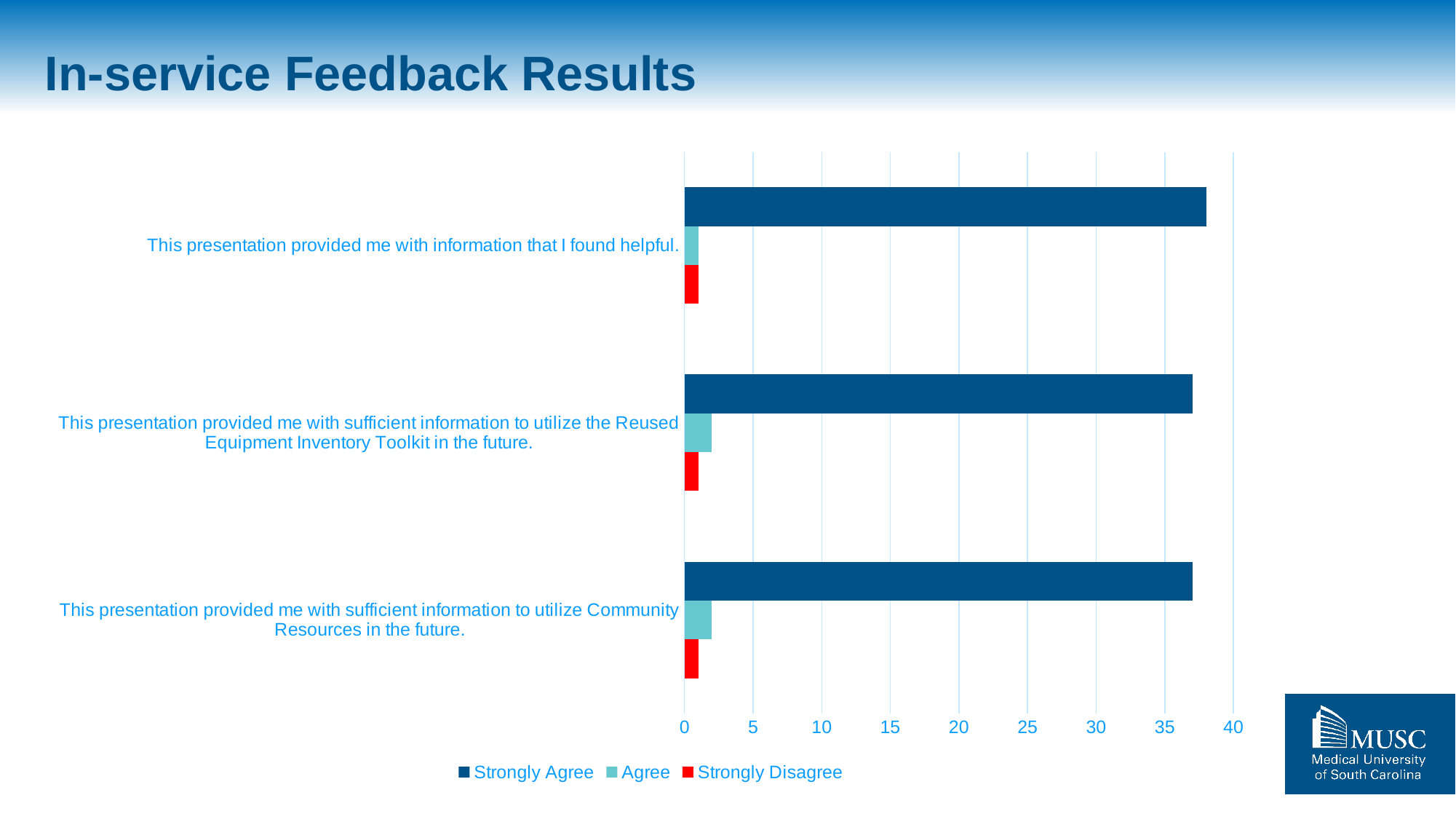
Is the Agree value for "This presentation provided me with sufficient information to utilize the Reused Equipment Inventory Toolkit in the future." greater or less than 5? less Is the Strongly Agree value for "This presentation provided me with information that I found helpful." greater or less than 35? greater Which series are listed in the legend? Strongly Agree, Agree, Strongly Disagree Is the Strongly Disagree value for "This presentation provided me with information that I found helpful." greater or less than 5? less How many statements (categories) are plotted on the chart? 3 What is the highest value shown on the horizontal axis? 40 For "This presentation provided me with sufficient information to utilize Community Resources in the future.", which is larger: Strongly Agree or Agree? Strongly Agree What is the title of the slide containing the chart? In-service Feedback Results Which series has the longest bar for every statement on the chart? Strongly Agree How many series does the legend list? 3 What kind of chart is shown on the slide? bar chart